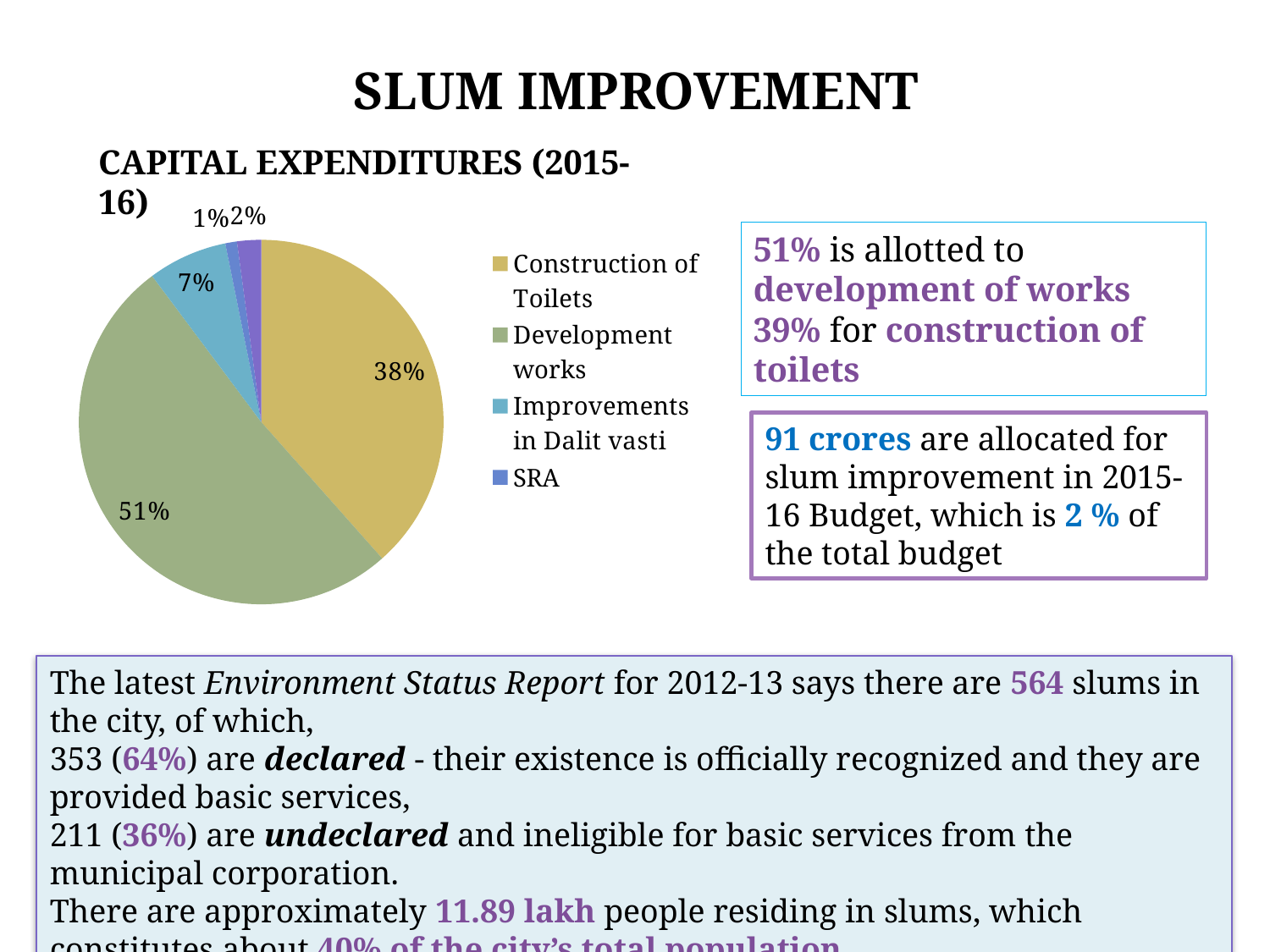
Which is larger in the pie chart: Construction of Toilets or Improvements in Dalit vasti? Construction of Toilets Which category has the largest share of the capital expenditure pie chart? Development works How many entries does the legend of the pie chart list? 4 What percentage of capital expenditure goes to Improvements in Dalit vasti in the pie chart? 7% What colour is the Development works slice in the pie chart? Green How many percentage labels are shown on the pie chart? 5 What percentage of capital expenditure goes to Development works in the pie chart? 51% What is the smallest percentage label shown on the pie chart? 1% What kind of chart is used to show the capital expenditures (2015-16)? Pie chart What percentage of capital expenditure goes to Construction of Toilets in the pie chart? 38% By how many percentage points does Development works exceed Construction of Toilets in the pie chart? 13 percentage points What is the title of the pie chart? CAPITAL EXPENDITURES (2015-16)